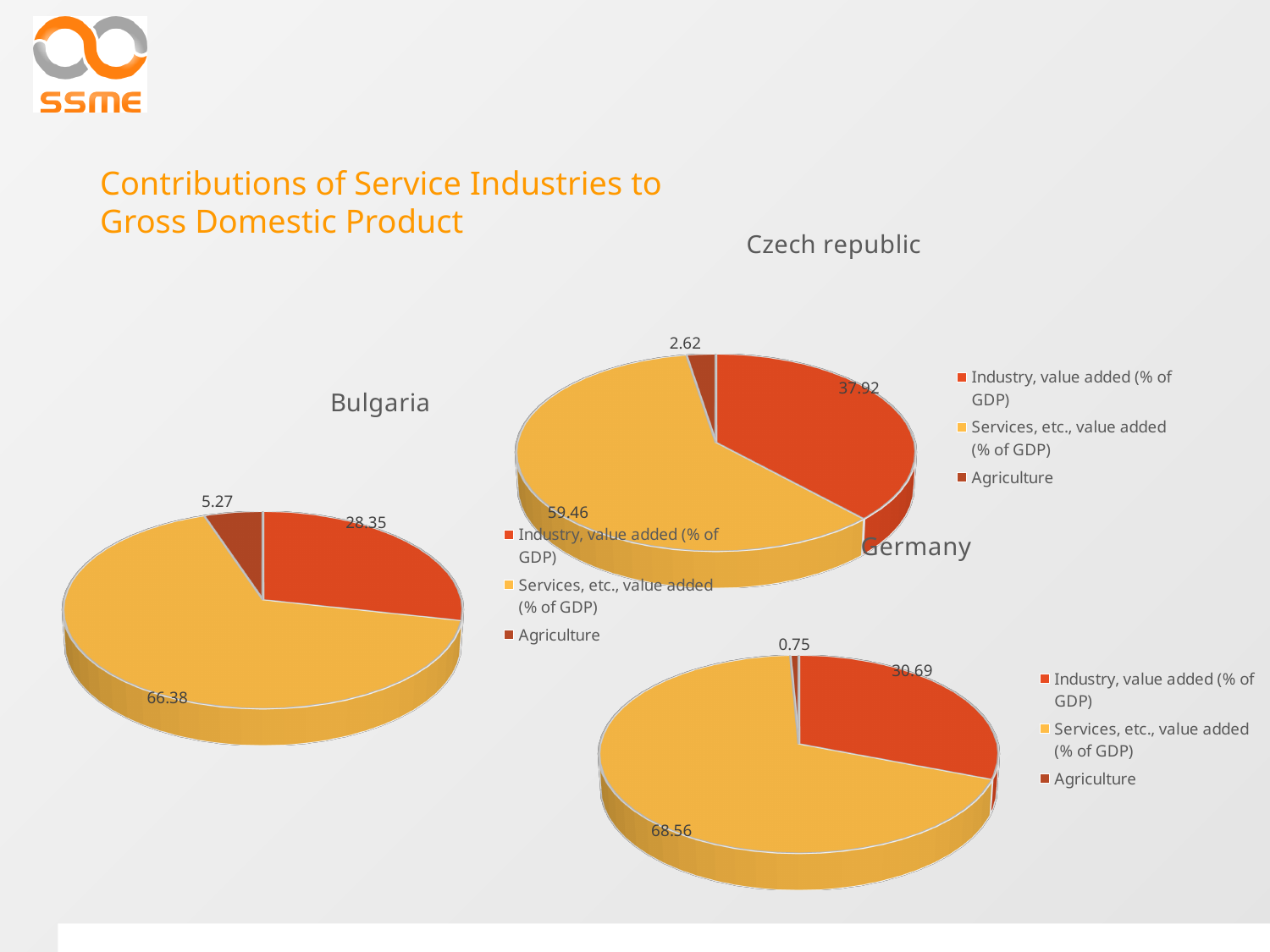
In the Bulgaria chart, what is the value for Agriculture? 5.27 How many pie charts are shown on the slide? 3 In the Bulgaria chart, what is the difference between the Services value and the Industry value? 38.03 In the Bulgaria chart, what is the value for Services, etc., value added (% of GDP)? 66.38 In the Germany chart, which category has the largest slice? Services, etc., value added (% of GDP) Which is larger: the Industry value in the Czech republic chart or the Industry value in the Germany chart? Czech republic In the Germany chart, what is the value for Agriculture? 0.75 How many entries does the legend of the Bulgaria chart list? 3 In the Czech republic chart, what is the value for Industry, value added (% of GDP)? 37.92 In the Czech republic chart, which category has the smallest slice? Agriculture How many slices does the Germany pie chart have? 3 What type of chart is used for Czech republic? Pie chart